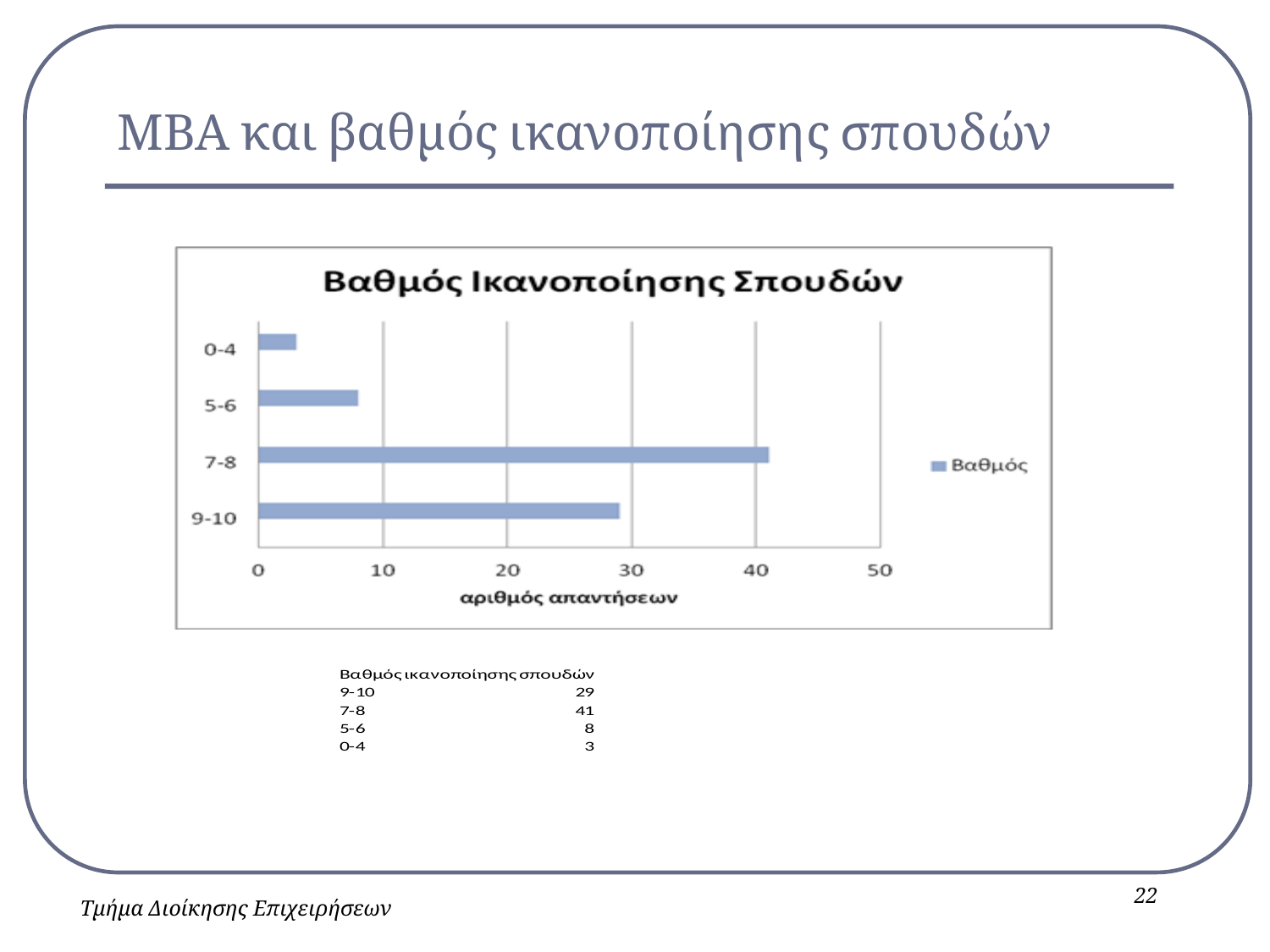
Which category has more responses, 5-6 or 9-10? 9-10 What is the difference in responses between the 7-8 and 9-10 categories? 12 What is the title of the chart? Βαθμός Ικανοποίησης Σπουδών What is the number of responses for the 0-4 category? 3 What is the number of responses for the 7-8 category? 41 How many series does the legend list? 1 Which category has the highest number of responses? 7-8 How many categories are plotted in the chart? 4 What type of chart is shown on the slide? bar chart Which category has the lowest number of responses? 0-4 Is the value for the 5-6 category greater or less than 10? less What is the number of responses for the 9-10 category? 29